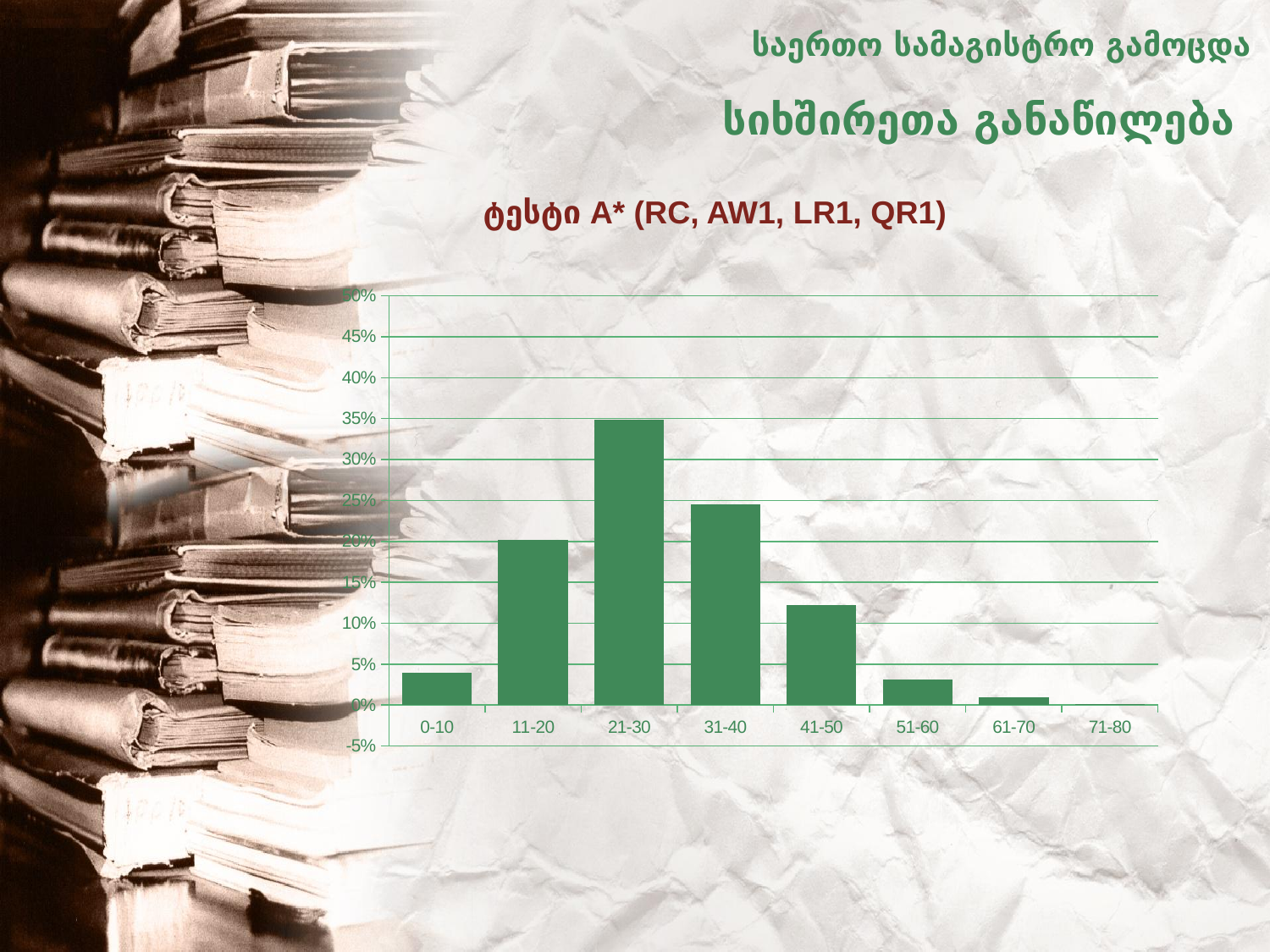
Is the value for 51-60 greater or less than 5%? less Which score range has the lowest bar? 71-80 Is the value for 41-50 greater or less than 10%? greater Do the values rise or fall along the x axis from 21-30 to 71-80? fall Which is larger, the value for 11-20 or the value for 31-40? 31-40 Is the value for 0-10 greater or less than 5%? less What kind of chart is shown on the slide? bar chart What is the title of the chart? ტესტი A* (RC, AW1, LR1, QR1) How many score-range categories are shown on the x axis? 8 Which score range has the highest bar? 21-30